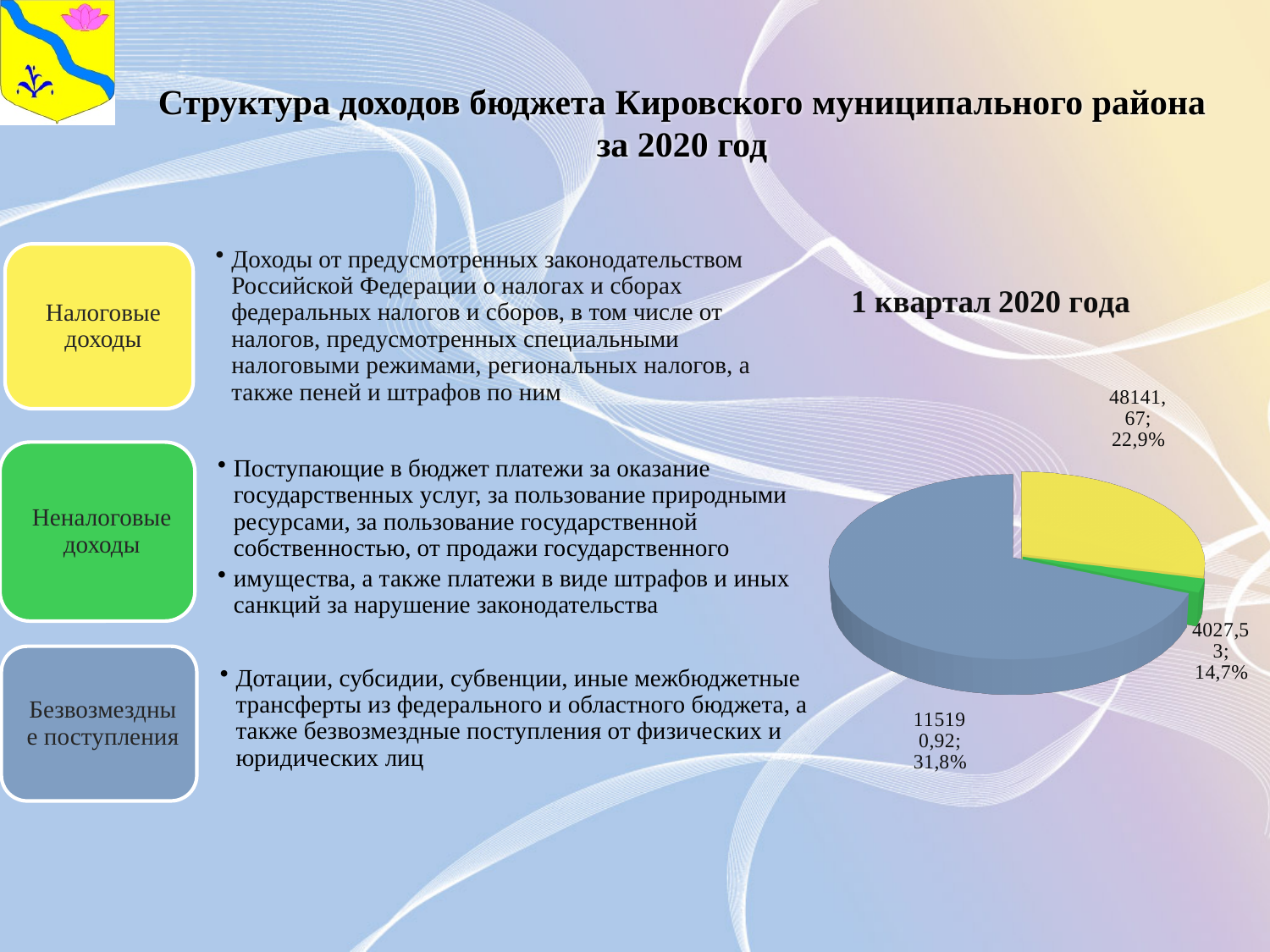
What value is printed on the blue slice of the pie chart? 115190,92 What is the title of the chart on the slide? 1 квартал 2020 года Which slice of the pie chart has the smallest value? the green slice (4027,53) Which slice of the pie chart has the largest value? the blue slice (115190,92) What value is printed on the yellow slice of the pie chart? 48141,67 What value is printed on the green slice of the pie chart? 4027,53 What is the difference between the values of the yellow slice and the green slice? 44114,14 What percentage share is shown for the green slice of the pie chart? 14,7% What percentage share is shown for the yellow slice of the pie chart? 22,9% How many slices does the pie chart have? 3 What kind of chart is shown on the slide? pie chart What percentage share is shown for the blue slice of the pie chart? 31,8%